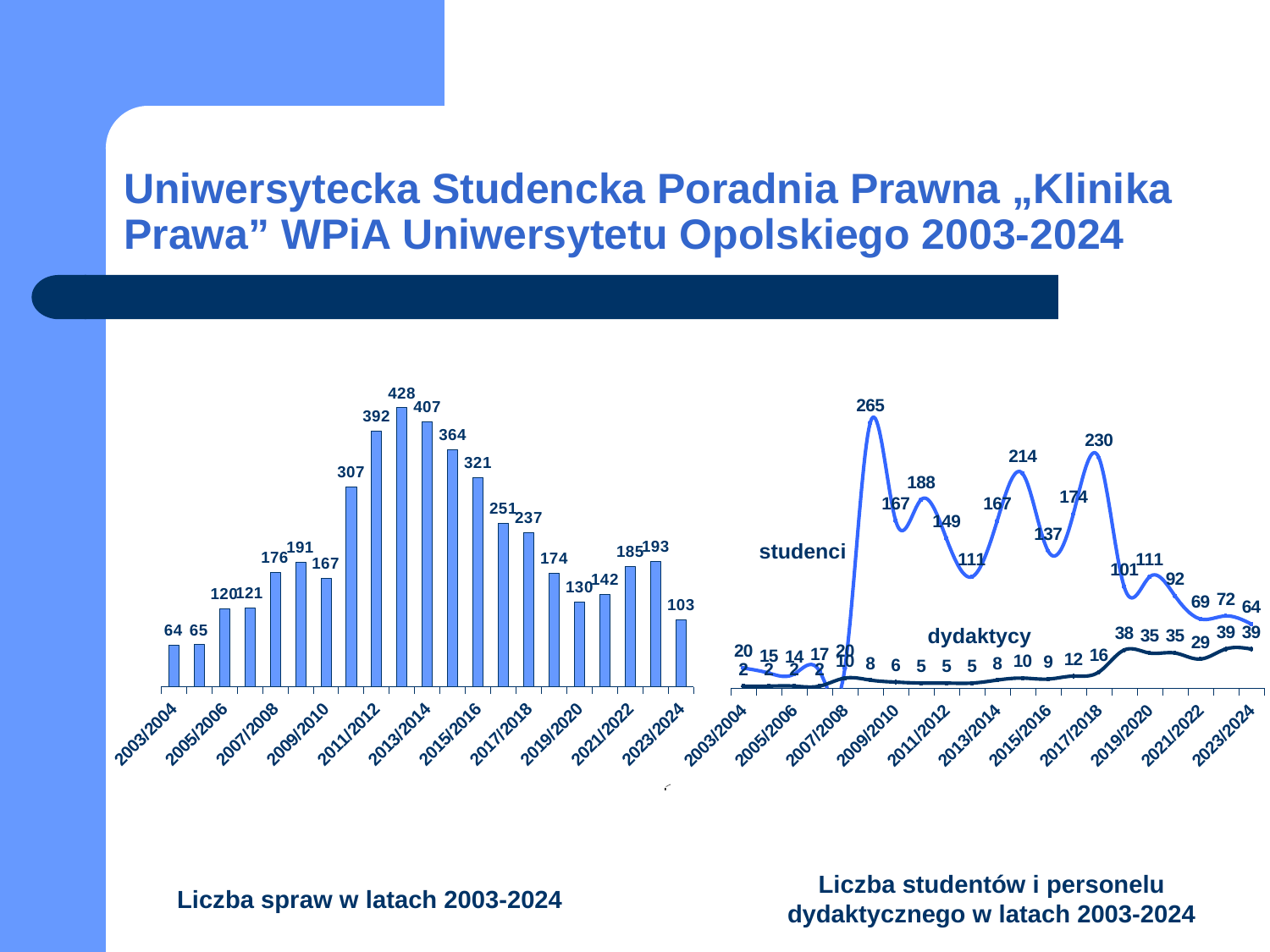
In the left chart, "Liczba spraw w latach 2003-2024", what is the value for 2011/2012? 392 How many series are plotted in the right chart, "Liczba studentów i personelu dydaktycznego w latach 2003-2024"? 2 In the right chart, "Liczba studentów i personelu dydaktycznego w latach 2003-2024", which series has the larger value in 2023/2024, studenci or dydaktycy? studenci In the left chart, "Liczba spraw w latach 2003-2024", what is the highest value shown? 428 In the left chart, "Liczba spraw w latach 2003-2024", what is the difference between the values for 2013/2014 and 2023/2024? 304 In the left chart, "Liczba spraw w latach 2003-2024", what is the value for 2023/2024? 103 In the left chart, "Liczba spraw w latach 2003-2024", what is the lowest value shown? 64 In the right chart, "Liczba studentów i personelu dydaktycznego w latach 2003-2024", what is the highest value of the studenci series? 265 How many bars are plotted in the left chart, "Liczba spraw w latach 2003-2024"? 21 In the left chart, "Liczba spraw w latach 2003-2024", do the values rise or fall from 2013/2014 to 2019/2020? fall What kind of chart is the left chart, "Liczba spraw w latach 2003-2024"? bar chart In the right chart, "Liczba studentów i personelu dydaktycznego w latach 2003-2024", what is the value of the dydaktycy series for 2023/2024? 39